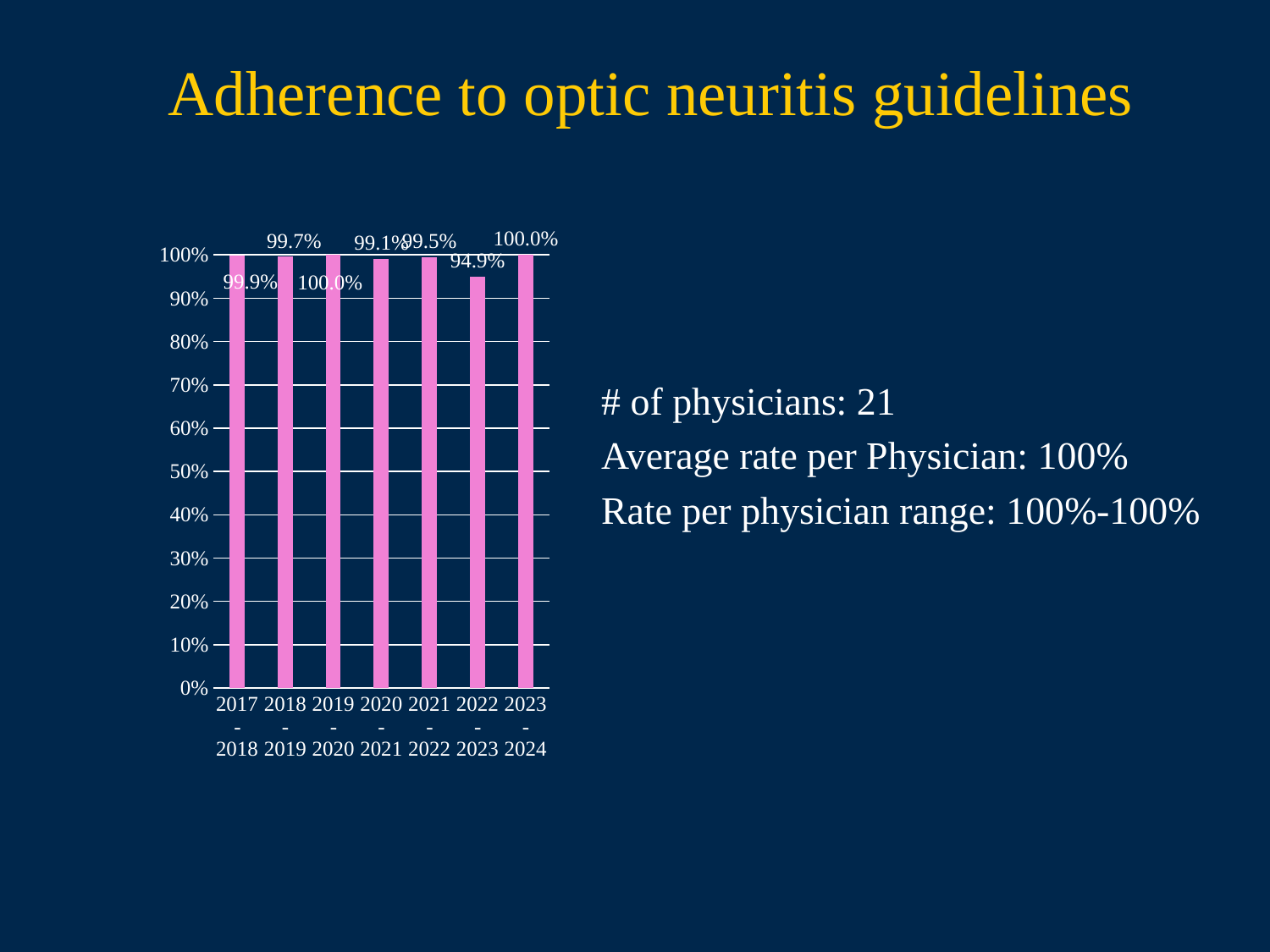
How many periods are shown on the x axis of the chart? 7 What is the adherence rate for 2020-2021? 99.1% What is the adherence rate for 2023-2024? 100.0% What kind of chart is shown on the slide? Bar chart From 2022-2023 to 2023-2024, does the adherence rate rise or fall? Rise What is the adherence rate for 2017-2018? 99.9% Is the value for 2022-2023 greater or less than 90%? greater What is the adherence rate for 2022-2023? 94.9% Which period has the lowest adherence rate? 2022-2023 What is the title of the slide containing the chart? Adherence to optic neuritis guidelines What is the difference between the adherence rate for 2023-2024 and the rate for 2022-2023? 5.1 percentage points Which period has the higher adherence rate, 2021-2022 or 2022-2023? 2021-2022